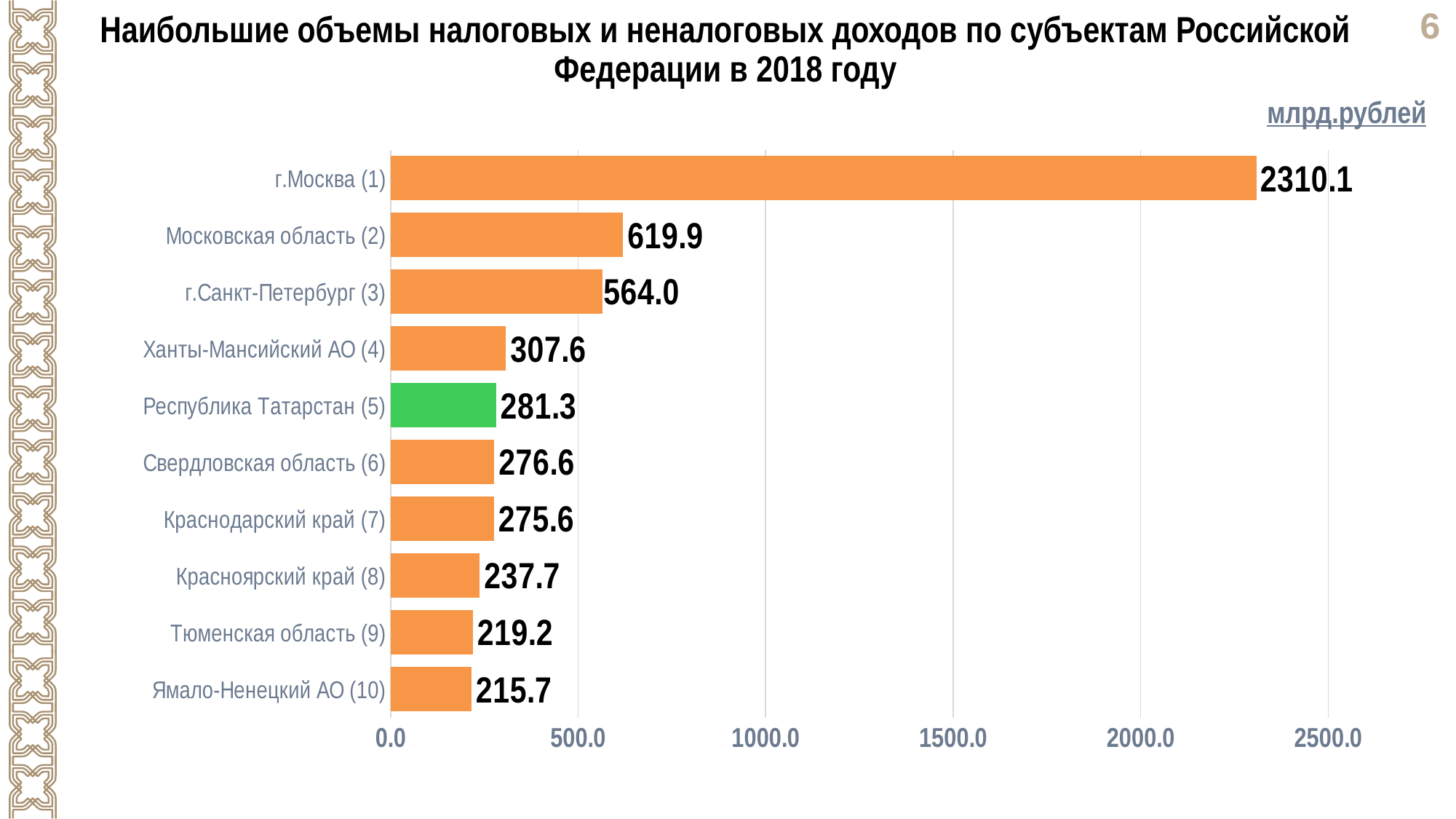
Which region's bar is coloured green instead of orange? Республика Татарстан (5) How many regions are shown in the chart? 10 What is the difference between the values for Московская область (2) and г.Санкт-Петербург (3)? 55.9 What is the value for Тюменская область (9)? 219.2 What is the value for г.Москва (1)? 2310.1 What is the value for Республика Татарстан (5)? 281.3 What is the difference between the values for г.Москва (1) and Ханты-Мансийский АО (4)? 2002.5 What kind of chart is shown on the slide? bar chart Is the value for Московская область (2) greater or less than 500.0? greater Which region has the highest value? г.Москва (1) Which region has the lowest value? Ямало-Ненецкий АО (10) Which is larger, the value for Красноярский край (8) or the value for Ямало-Ненецкий АО (10)? Красноярский край (8)